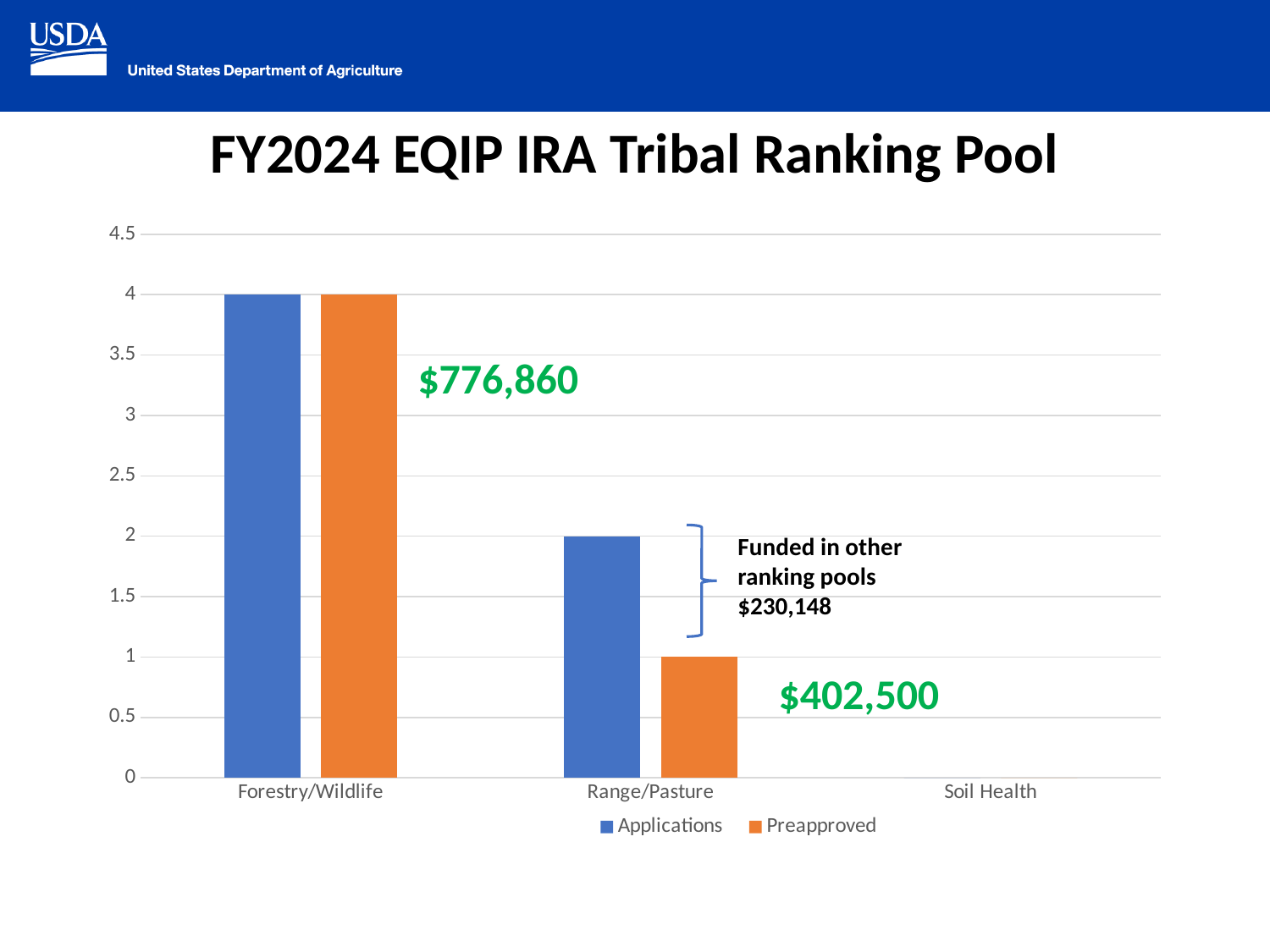
Which category has the highest Applications value? Forestry/Wildlife What is the title of the chart? FY2024 EQIP IRA Tribal Ranking Pool What is the Applications value for Forestry/Wildlife? 4 What type of chart is shown on the slide? Bar chart What is the difference between Applications and Preapproved for Range/Pasture? 1 What dollar amount is annotated next to the Range/Pasture bars in green? $402,500 Which is larger for Range/Pasture, Applications or Preapproved? Applications How many categories are shown on the x axis? 3 How many series does the legend list? 2 What is the Applications value for Range/Pasture? 2 What is the Preapproved value for Range/Pasture? 1 Is the Preapproved value for Forestry/Wildlife greater or less than 3? greater